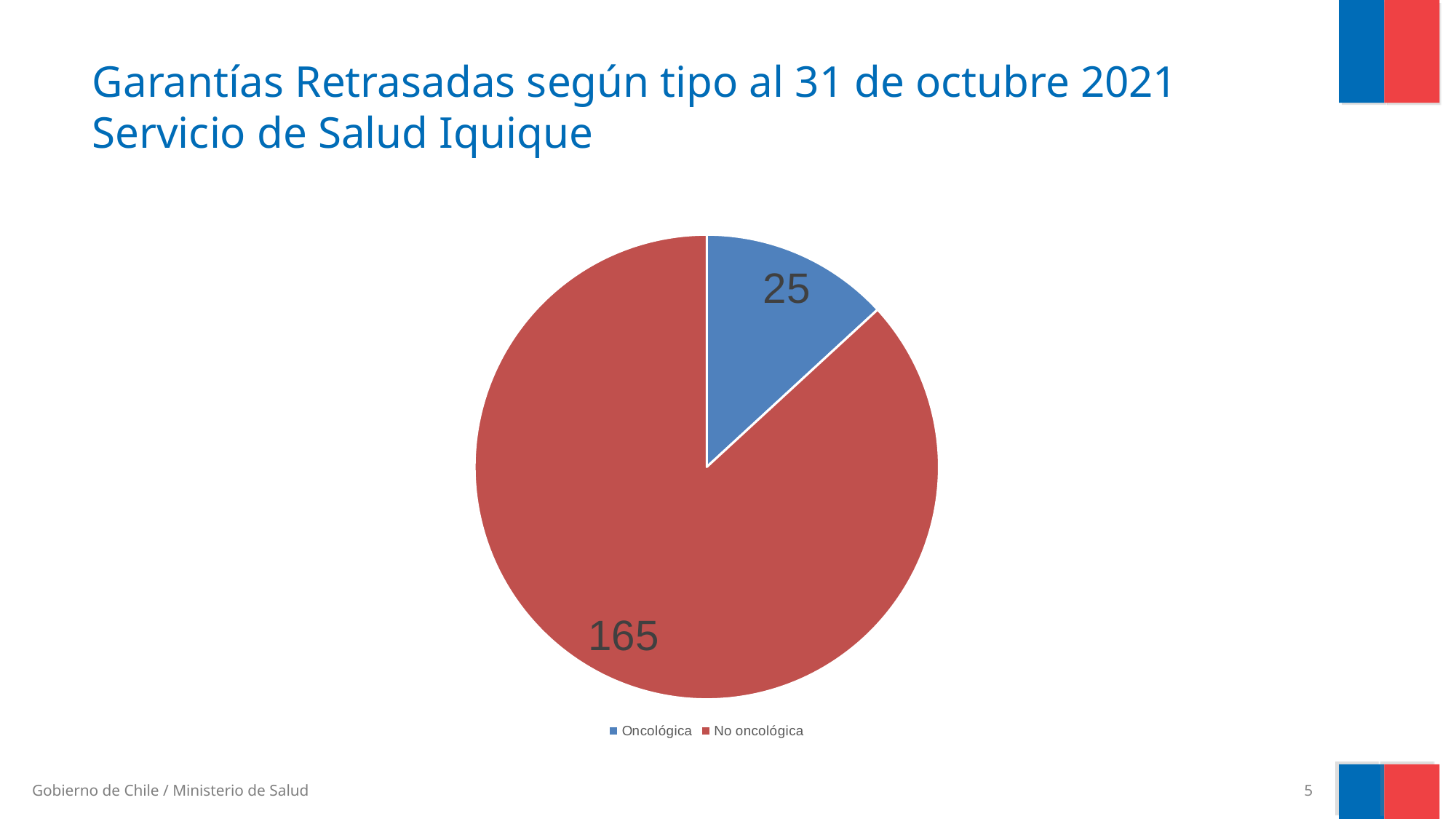
What kind of chart is shown on the slide? Pie chart What is the title of the slide? Garantías Retrasadas según tipo al 31 de octubre 2021 Servicio de Salud Iquique What is the total of all slices in the pie chart? 190 What is the difference between the No oncológica and Oncológica values? 140 What share of the pie does the No oncológica slice represent, to the nearest whole percent? 87% Which category has the smallest slice? Oncológica How many categories does the pie chart show? 2 Which is larger, Oncológica or No oncológica? No oncológica What is the value for No oncológica? 165 What colour is the Oncológica slice? Blue Which category has the largest slice? No oncológica What is the value for Oncológica? 25